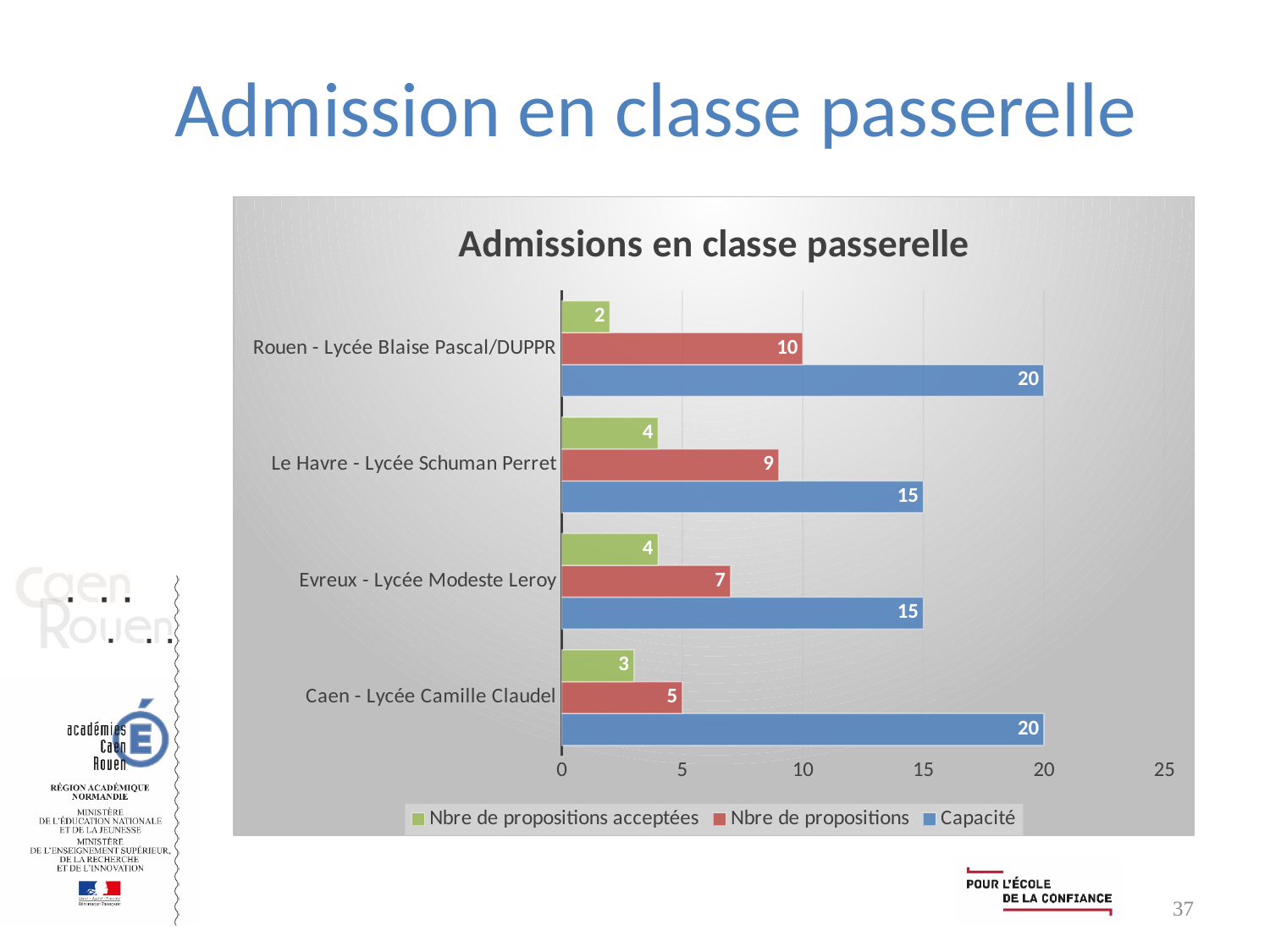
Which category has the highest Nbre de propositions? Rouen - Lycée Blaise Pascal/DUPPR What is the Capacité value for Rouen - Lycée Blaise Pascal/DUPPR? 20 Which is larger: Nbre de propositions for Evreux - Lycée Modeste Leroy or for Le Havre - Lycée Schuman Perret? Le Havre - Lycée Schuman Perret What is the Nbre de propositions acceptées value for Caen - Lycée Camille Claudel? 3 What is the difference between Capacité and Nbre de propositions for Caen - Lycée Camille Claudel? 15 How many series does the legend list? 3 What kind of chart is shown on the slide? bar chart Which category has the lowest Nbre de propositions acceptées? Rouen - Lycée Blaise Pascal/DUPPR What is the Nbre de propositions value for Le Havre - Lycée Schuman Perret? 9 What is the title of the chart? Admissions en classe passerelle How many categories (lycées) are shown on the chart? 4 Is the Capacité value for Le Havre - Lycée Schuman Perret greater or less than 10? greater